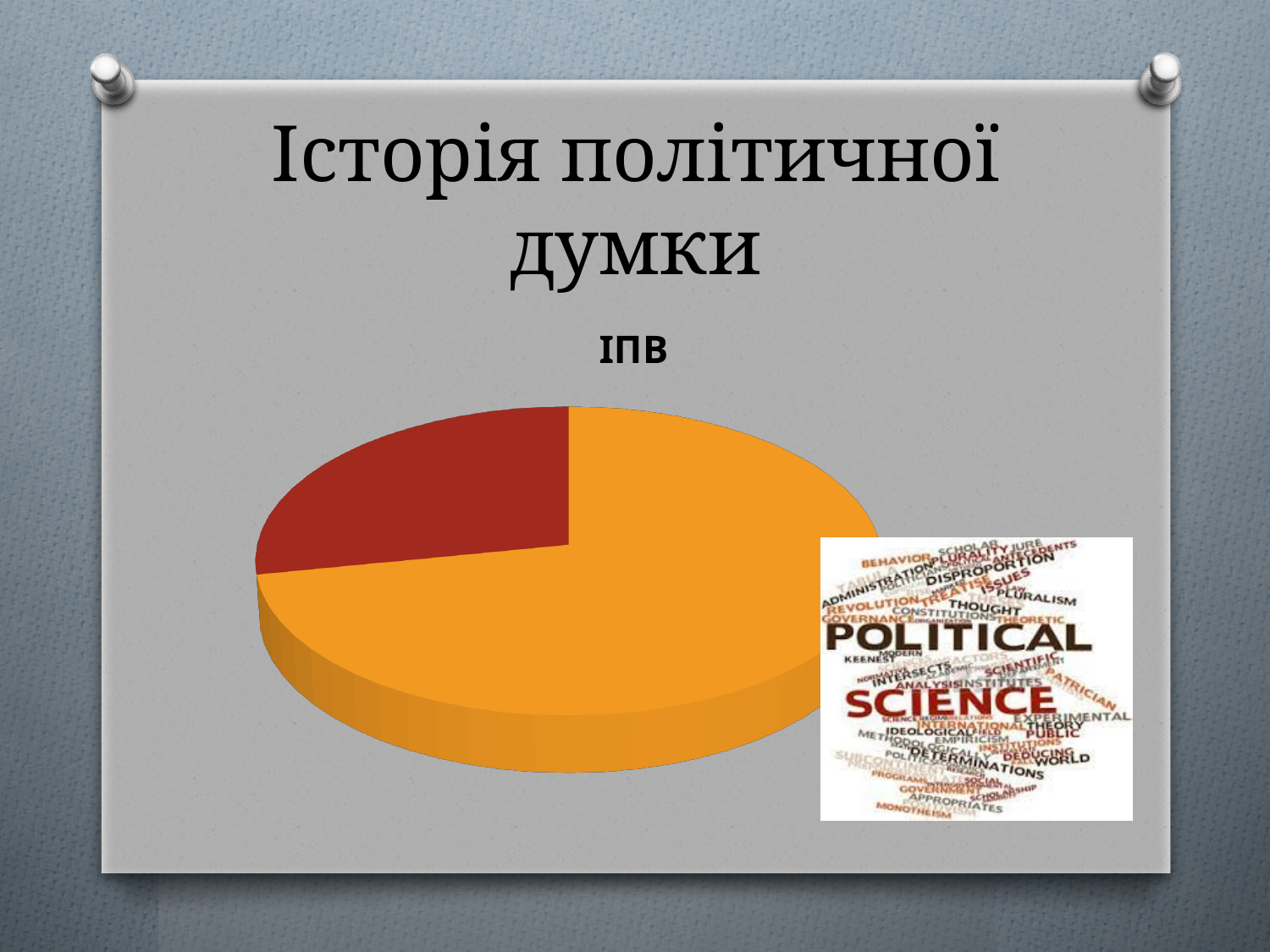
What kind of chart is shown on the slide? pie chart Does the orange slice take up more or less than half of the pie? more What is the title of the pie chart? ІПВ What colour is the largest slice of the pie chart? orange What colour is the smallest slice of the pie chart? dark red Does the pie chart display a legend? no Which slice of the pie chart is larger, the orange one or the dark red one? the orange one How many slices does the pie chart have? 2